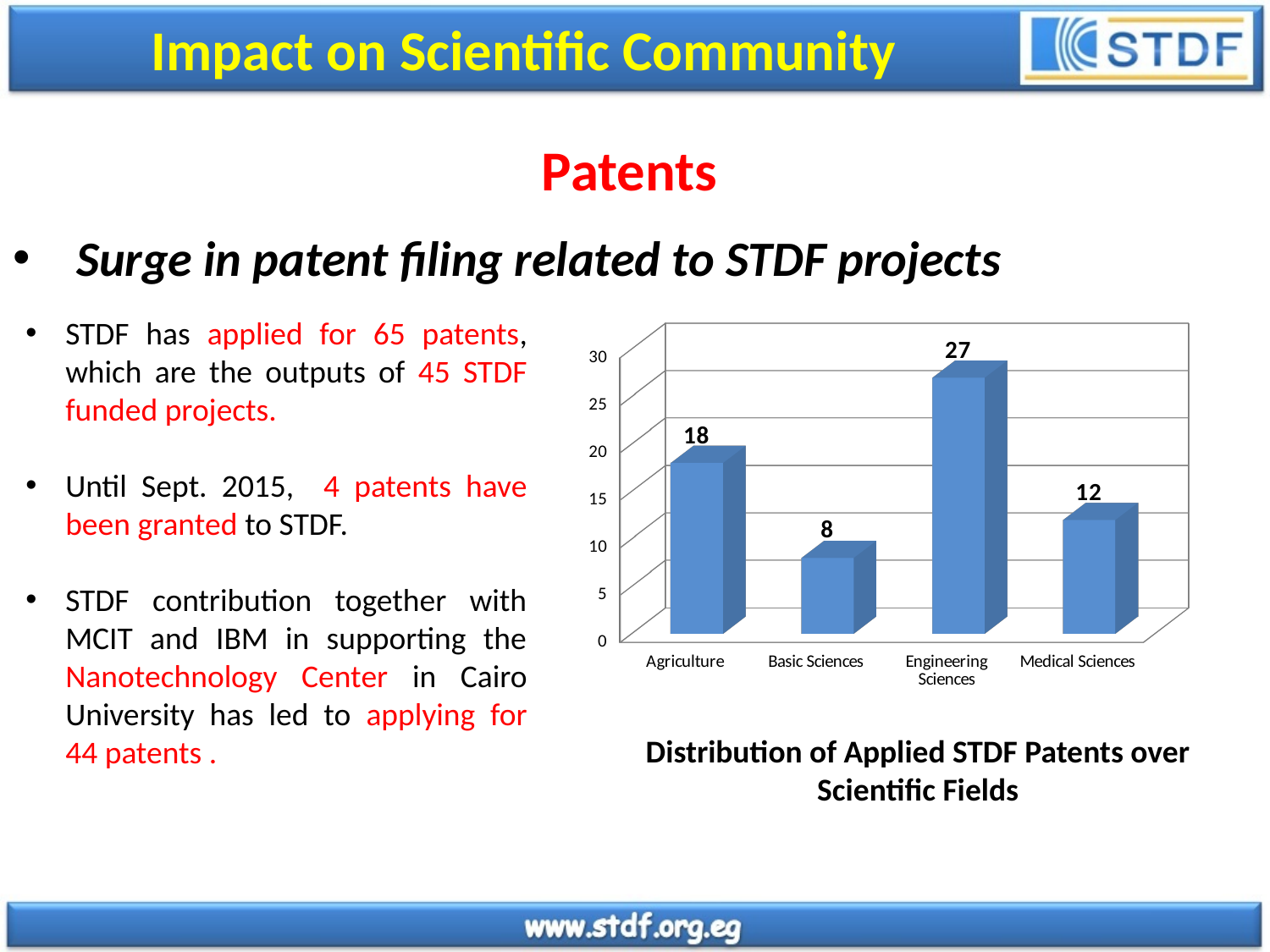
Which scientific field has the highest number of applied patents? Engineering Sciences How many scientific fields are shown on the chart? 4 How many patents were applied for in Agriculture? 18 What kind of chart is shown on the slide? Bar chart What is the value shown for Medical Sciences? 12 Which has a larger value, Agriculture or Medical Sciences? Agriculture What is the difference between the values for Medical Sciences and Basic Sciences? 4 Which scientific field has the lowest number of applied patents? Basic Sciences What is the title of the chart? Distribution of Applied STDF Patents over Scientific Fields What is the value shown for Basic Sciences? 8 What is the difference between the values for Engineering Sciences and Agriculture? 9 What is the value shown for Engineering Sciences? 27